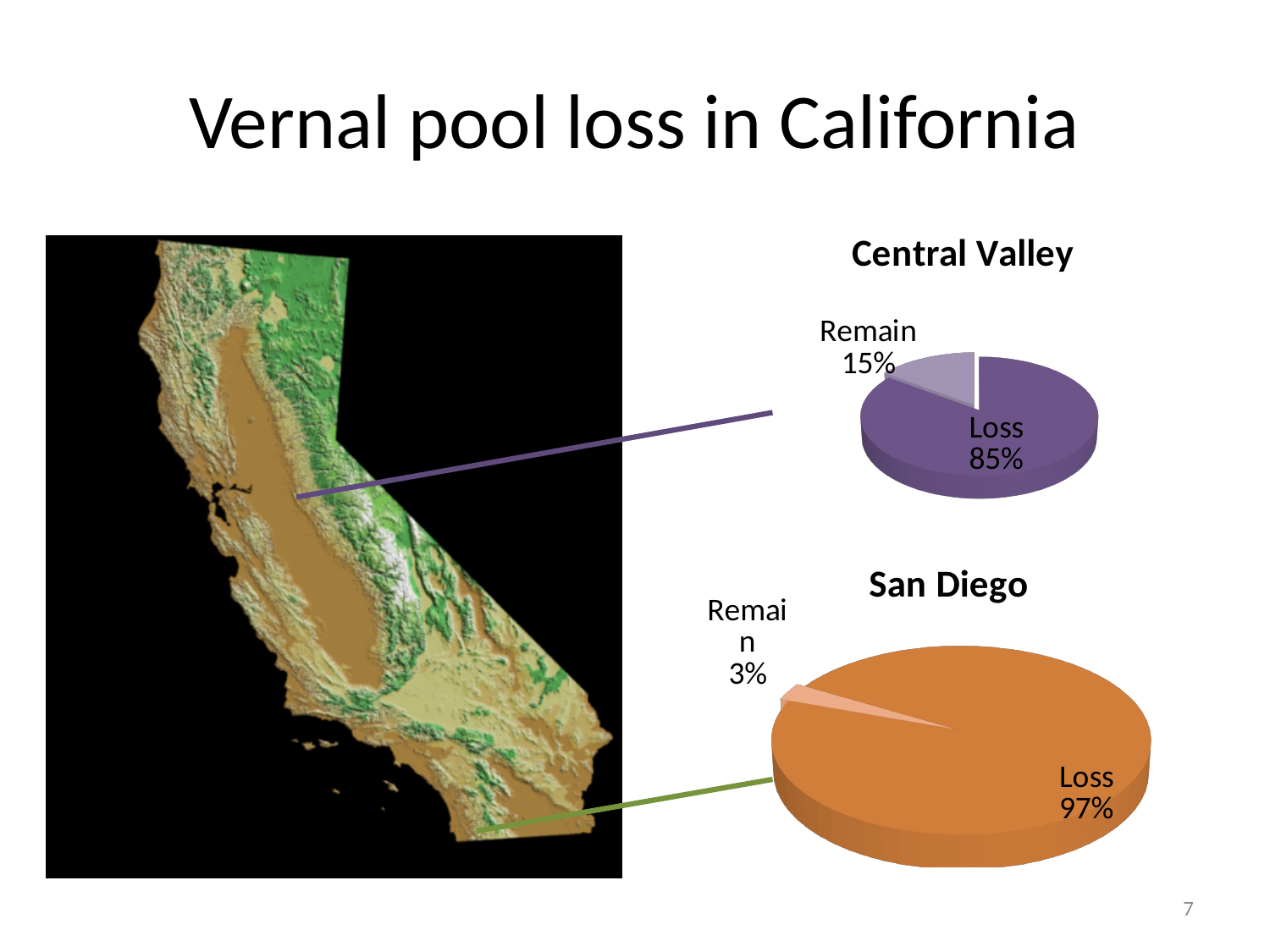
In the Central Valley chart, which slice is the largest? Loss In the San Diego chart, what percentage is labelled Loss? 97% In the San Diego chart, which slice is the smallest? Remain In the Central Valley chart, what is the difference between the Loss and Remain percentages? 70% What is the title of the chart at the bottom right of the slide? San Diego In the Central Valley chart, what percentage is labelled Remain? 15% What kind of chart is the Central Valley chart? Pie chart What colour is the Loss slice in the San Diego chart? Orange Which is larger: the Loss share in the Central Valley chart or the Loss share in the San Diego chart? San Diego How many slices does the San Diego chart have? 2 In the San Diego chart, what percentage is labelled Remain? 3% In the Central Valley chart, what percentage is labelled Loss? 85%